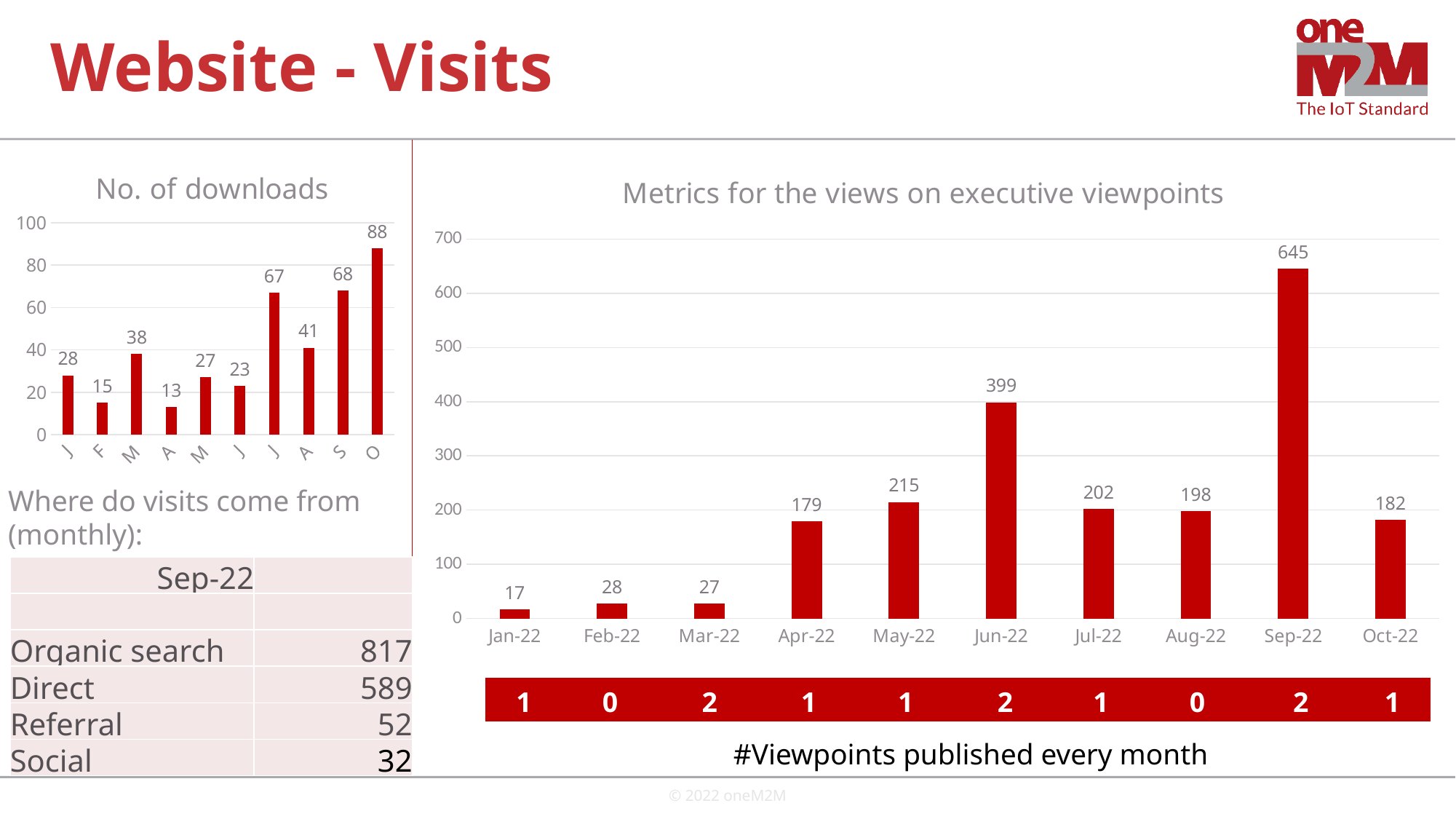
In the 'Metrics for the views on executive viewpoints' chart, which month has the lowest value? Jan-22 In the 'No. of downloads' chart, what is the difference between the values for the bars labelled 88 and 68? 20 In the 'Metrics for the views on executive viewpoints' chart, what is the value for Sep-22? 645 What kind of chart is the 'Metrics for the views on executive viewpoints' chart? bar chart In the 'Metrics for the views on executive viewpoints' chart, what is the difference between the values for Jun-22 and May-22? 184 In the 'Metrics for the views on executive viewpoints' chart, which is larger, the value for Jul-22 or Aug-22? Jul-22 How many bars are in the 'No. of downloads' chart? 10 In the 'Metrics for the views on executive viewpoints' chart, is the value for Apr-22 greater or less than 200? less In the 'No. of downloads' chart, what is the value for the last bar (O)? 88 In the 'No. of downloads' chart, which bar has the lowest value? A (13) How many months are shown in the 'Metrics for the views on executive viewpoints' chart? 10 In the 'Metrics for the views on executive viewpoints' chart, which month has the highest value? Sep-22